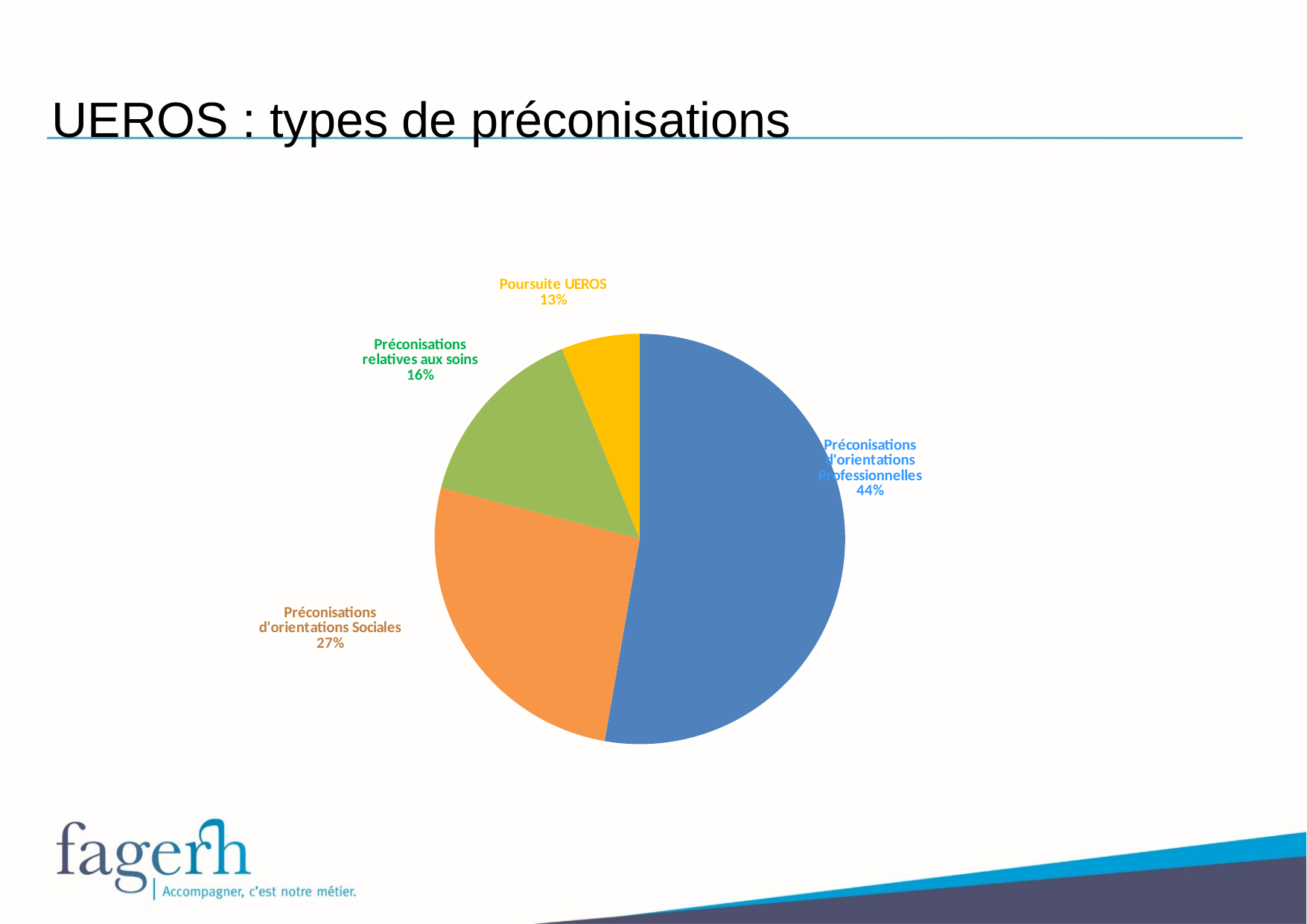
How many categories are shown in the pie chart? 4 What is the title of the slide? UEROS : types de préconisations What is the difference in percentage points between Préconisations d'orientations Professionnelles and Préconisations d'orientations Sociales? 17 What share of the pie is Poursuite UEROS? 13% What colour is the slice for Préconisations d'orientations Sociales? Orange What share of the pie is Préconisations d'orientations Professionnelles? 44% What share of the pie is Préconisations d'orientations Sociales? 27% Which category has the largest share of the pie? Préconisations d'orientations Professionnelles Which is larger: Préconisations relatives aux soins or Poursuite UEROS? Préconisations relatives aux soins Which category has the smallest share of the pie? Poursuite UEROS What kind of chart is shown on the slide? Pie chart